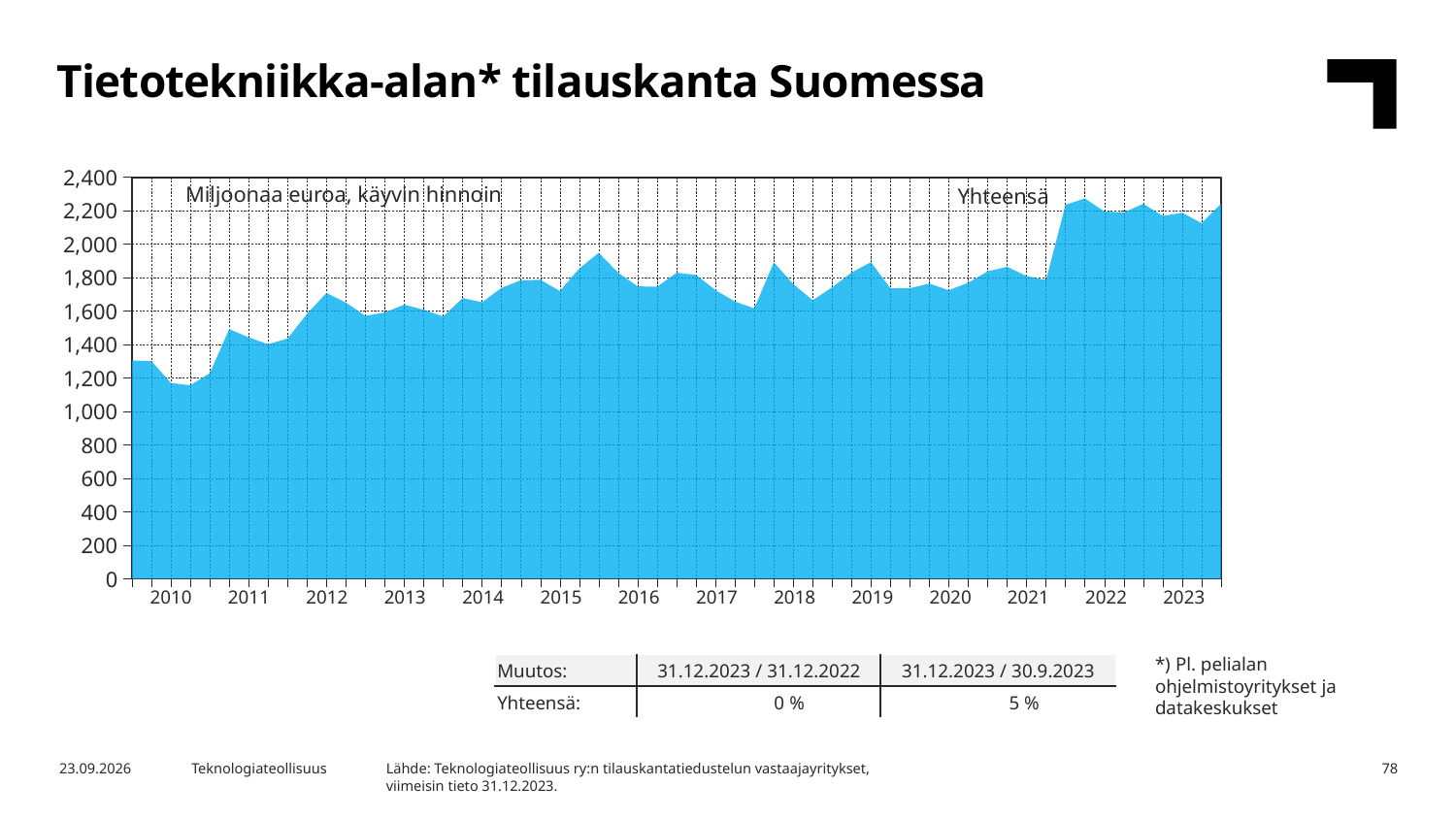
How many years are labelled on the x axis of the chart? 14 What kind of chart is shown on the slide? Area chart Is the value at the start of 2010 greater or less than 1,000? greater Is the value in 2022 greater or less than 2,000? greater In what unit are the values of the chart expressed, according to the label inside the plot area? Miljoonaa euroa, käyvin hinnoin Overall, do the values rise or fall from 2010 to 2023? rise Is the value in 2017 greater or less than 2,000? less Which year on the x axis shows the lowest values of the order backlog? 2010 According to the table below the chart, what is the change (Muutos) for Yhteensä between 31.12.2022 and 31.12.2023? 0 % What is the name of the series shown in the chart? Yhteensä